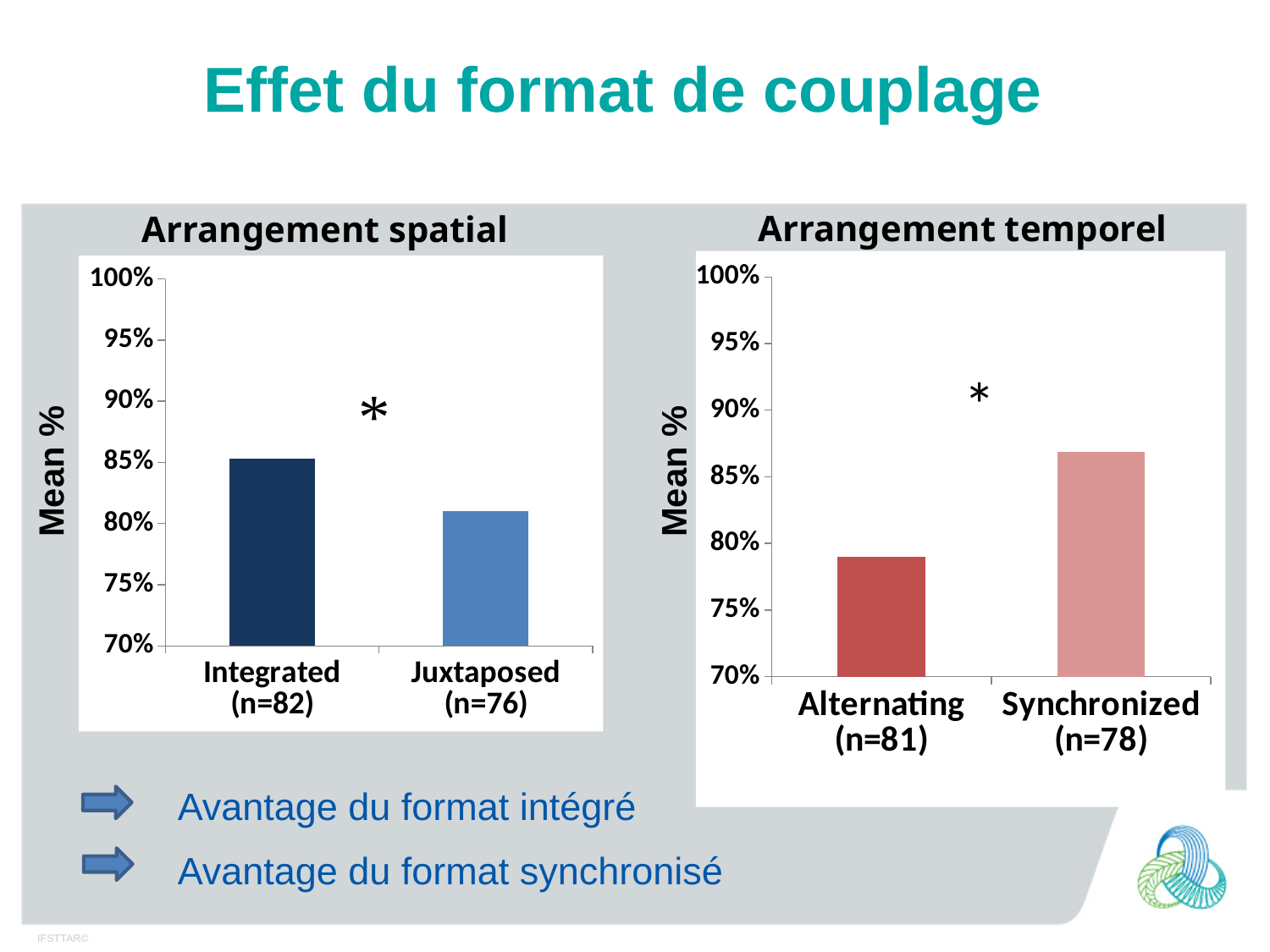
What type of chart is the 'Arrangement spatial' chart? bar chart In the 'Arrangement spatial' chart, is the value for Integrated (n=82) greater or less than 80%? greater What is the title of the chart on the left side of the slide? Arrangement spatial In the 'Arrangement spatial' chart, which category has the highest value? Integrated (n=82) In the 'Arrangement temporel' chart, is the value for Synchronized (n=78) greater or less than 85%? greater In the 'Arrangement spatial' chart, is the value for Juxtaposed (n=76) greater or less than 85%? less In the 'Arrangement temporel' chart, which is larger, Alternating (n=81) or Synchronized (n=78)? Synchronized (n=78) What is the y-axis label of the 'Arrangement temporel' chart? Mean % In the 'Arrangement spatial' chart, which category has the lowest value? Juxtaposed (n=76) How many categories are shown in the 'Arrangement spatial' chart? 2 In the 'Arrangement temporel' chart, which category has the highest value? Synchronized (n=78)